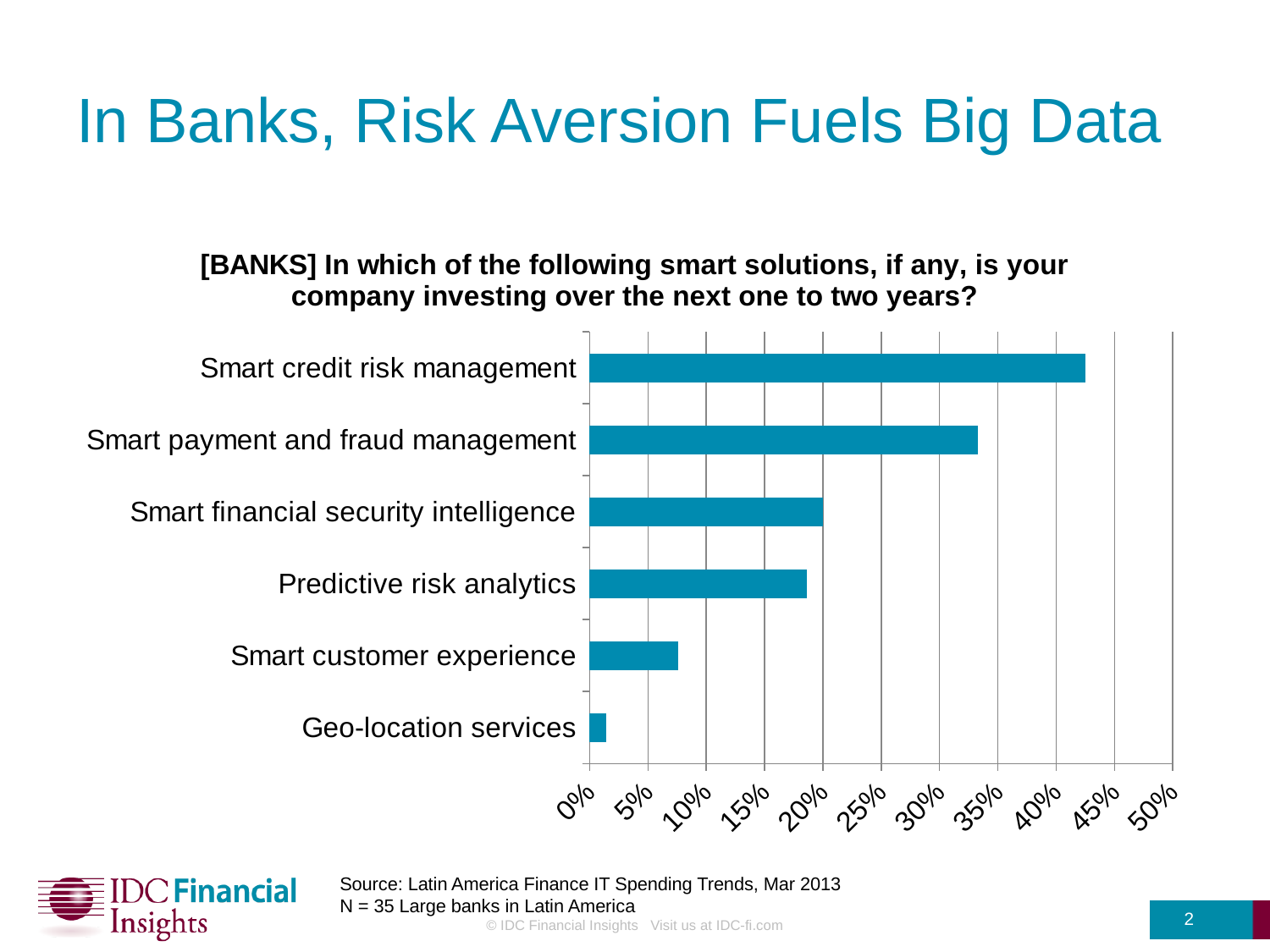
Is the value for Geo-location services greater or less than 5%? less Which smart solution has the highest share of banks investing in it? Smart credit risk management How many smart solution categories are plotted in the chart? 6 Which is larger: the value for Smart financial security intelligence or the value for Smart customer experience? Smart financial security intelligence Which is larger: the value for Smart payment and fraud management or the value for Predictive risk analytics? Smart payment and fraud management Is the value for Smart payment and fraud management greater or less than 30%? greater Which smart solution has the lowest share of banks investing in it? Geo-location services Is the value for Predictive risk analytics greater or less than 20%? less What kind of chart is shown on the slide? bar chart According to the note below the chart, how many large banks in Latin America were surveyed (N)? 35